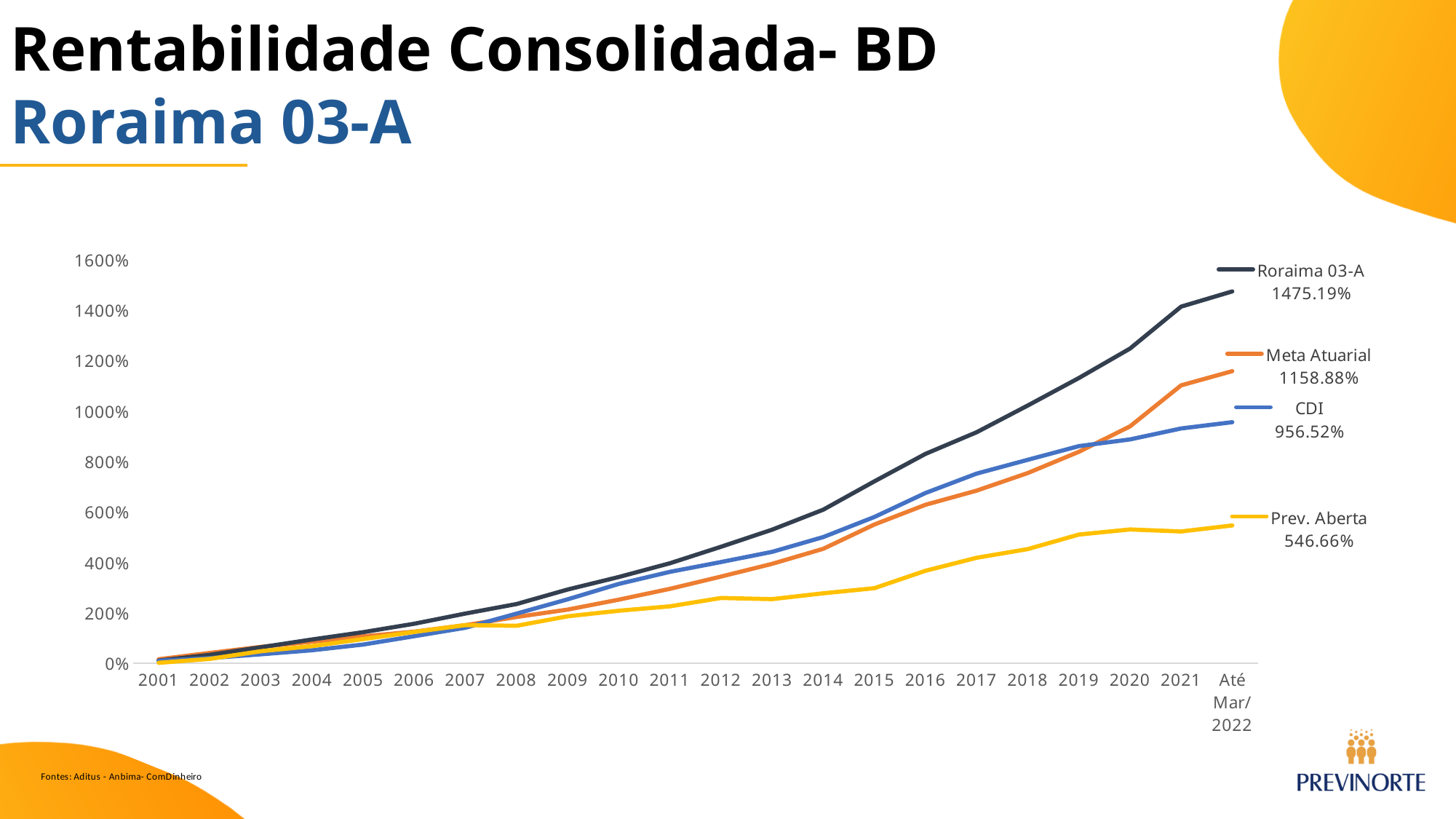
What is the final value shown for Roraima 03-A at Até Mar/2022? 1475.19% Which series has the highest value at Até Mar/2022? Roraima 03-A What kind of chart is shown on the slide? Line chart What is the final value shown for CDI? 956.52% How many series does the chart show? 4 Is the value for Roraima 03-A in 2021 greater or less than 1200%? greater Do the values for Roraima 03-A rise or fall from 2001 to Até Mar/2022? Rise What is the difference between the final values of Roraima 03-A and Meta Atuarial? 316.31% What is the final value shown for Meta Atuarial? 1158.88% Which is larger at Até Mar/2022, CDI or Meta Atuarial? Meta Atuarial Which series has the lowest value at Até Mar/2022? Prev. Aberta What is the final value shown for Prev. Aberta? 546.66%